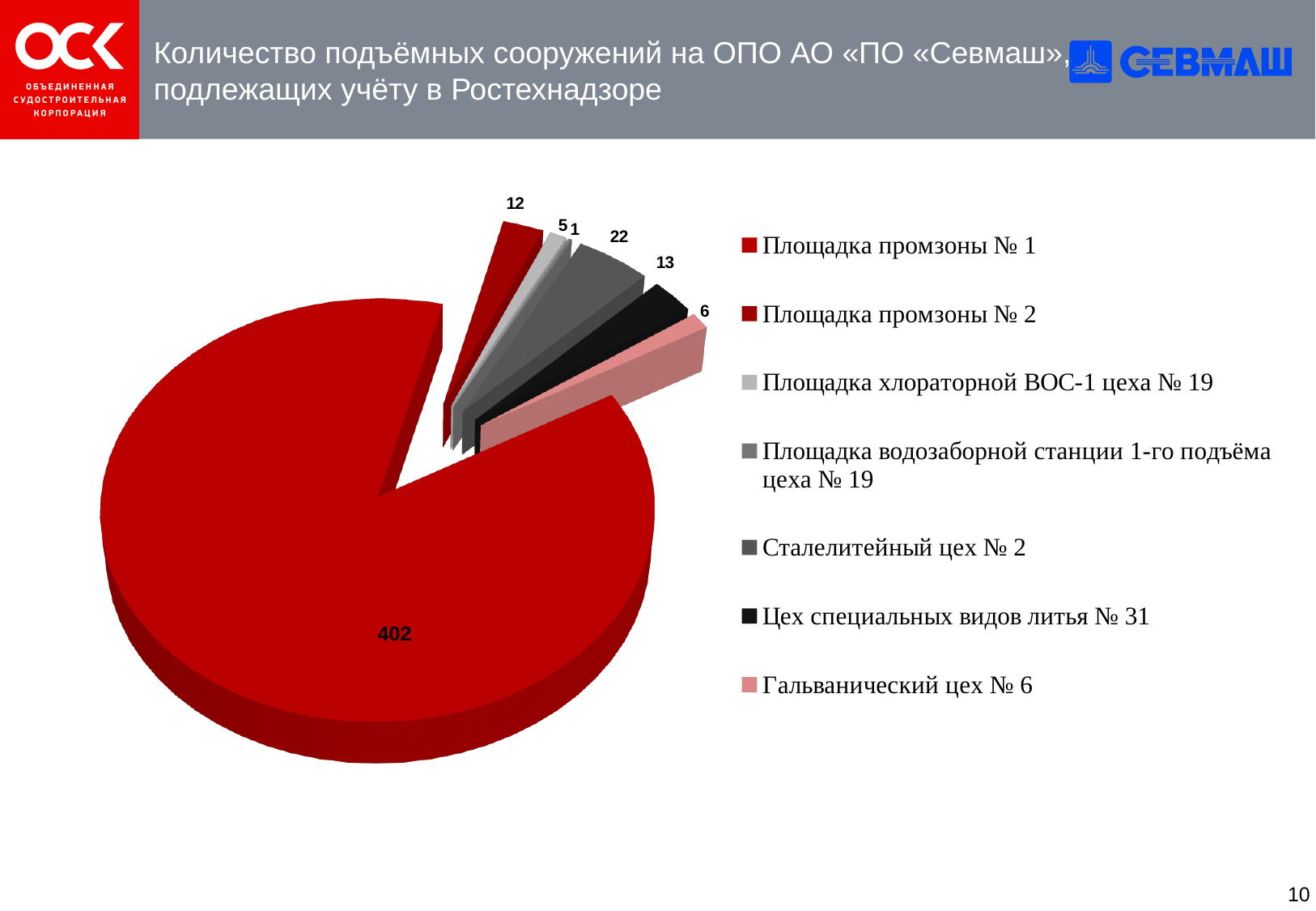
What is the value for Площадка промзоны № 1? 402 Which category has the smallest slice? Площадка водозаборной станции 1-го подъёма цеха № 19 Which category has the largest slice? Площадка промзоны № 1 Which is larger, the value for Площадка промзоны № 2 or the value for Гальванический цех № 6? Площадка промзоны № 2 What is the difference between the values for Сталелитейный цех № 2 and Цех специальных видов литья № 31? 9 How many slices does the pie chart have? 7 What is the value for Цех специальных видов литья № 31? 13 What is the value for Площадка промзоны № 2? 12 What kind of chart is shown on the slide? pie chart What is the value for Гальванический цех № 6? 6 What is the value for Сталелитейный цех № 2? 22 How many entries does the legend list? 7